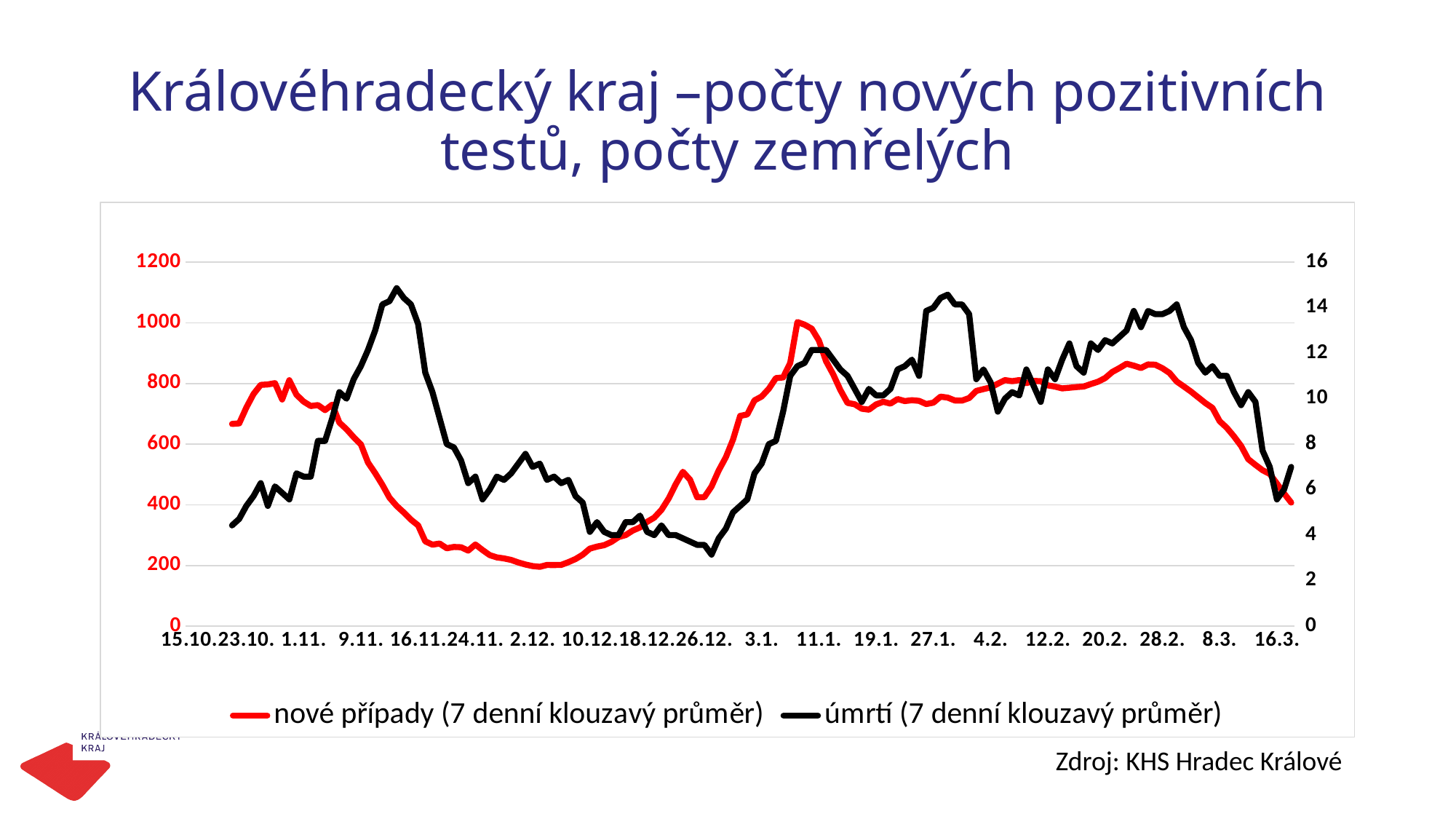
Which series is drawn in red according to the legend? nové případy (7 denní klouzavý průměr) Does the red line (nové případy) rise or fall between 10.12. and 11.1.? rise How many series does the legend list? 2 Is the value of the red line (nové případy) at 2.12. greater or less than 400? less Is the value of the red line (nové případy) at 16.11. greater or less than 400? less Does the red line (nové případy) rise or fall between 1.11. and 2.12.? fall Is the value of the black line (úmrtí) at 26.12. greater or less than 6 on the right axis? less What kind of chart is shown on the slide? line chart Does the black line (úmrtí) rise or fall between 16.11. and 26.12.? fall What is the highest value shown on the left vertical axis? 1200